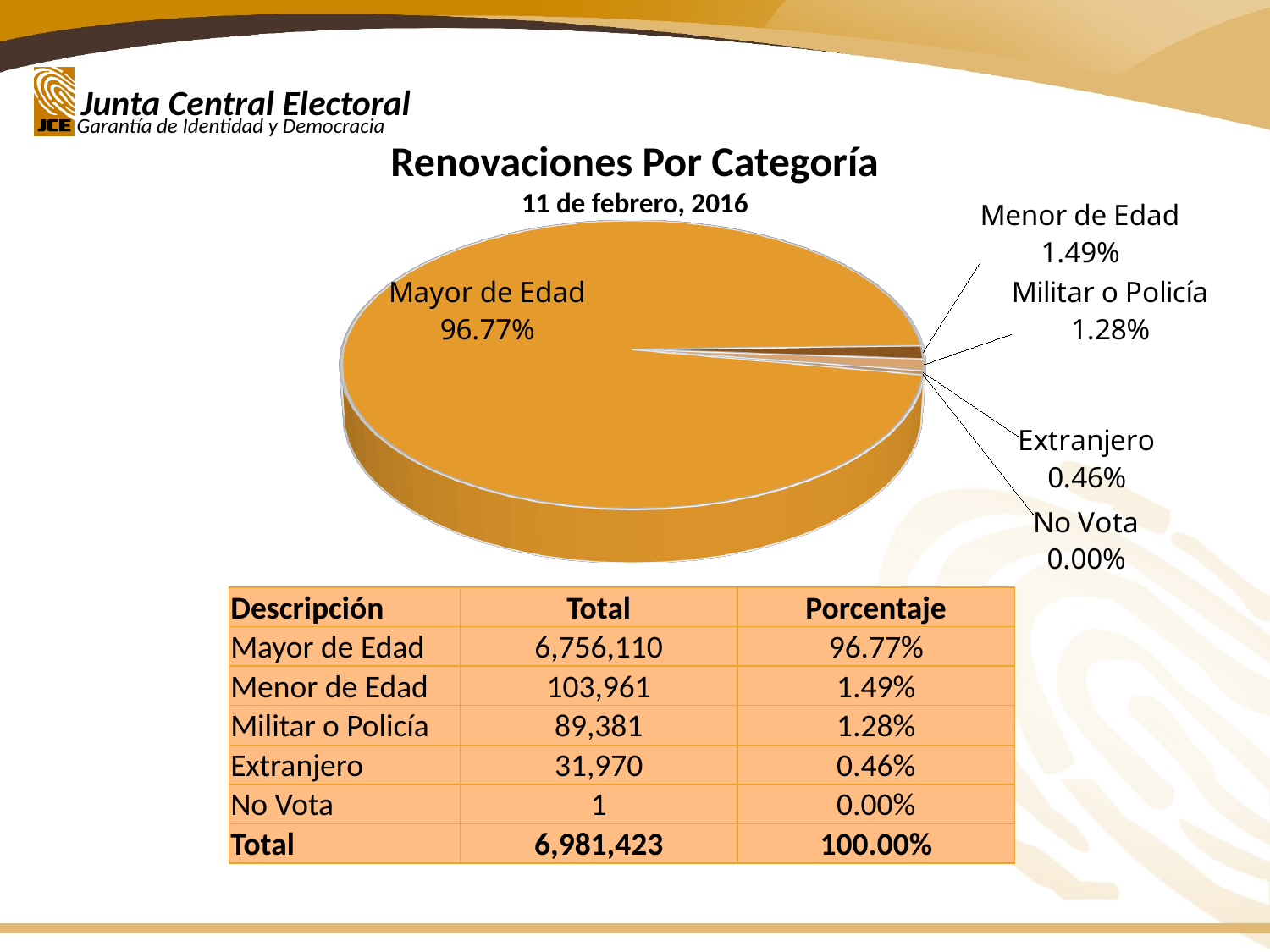
What kind of chart is shown on the slide? Pie chart What share of the pie does No Vota represent? 0.00% What share of the pie does Menor de Edad represent? 1.49% Which category has the smallest slice of the pie? No Vota Which has a larger share, Menor de Edad or Extranjero? Menor de Edad What share of the pie does Extranjero represent? 0.46% What is the difference in percentage points between the Menor de Edad and Militar o Policía shares? 0.21% What is the title of the chart? Renovaciones Por Categoría How many categories are shown in the pie chart? 5 Which category has the largest slice of the pie? Mayor de Edad